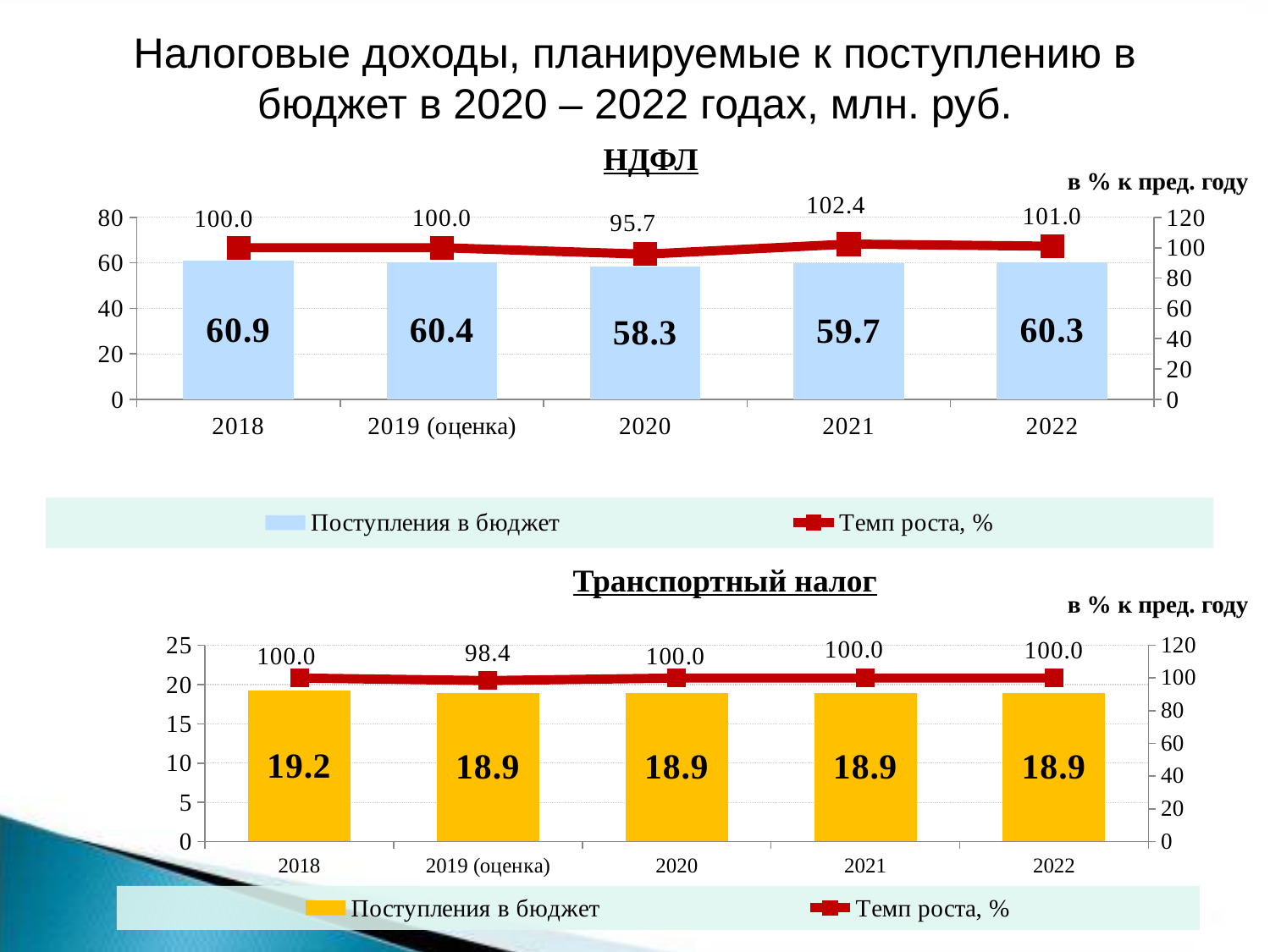
In the НДФЛ chart, which year has the lowest Поступления в бюджет value? 2020 How many years are shown on the x axis of the Транспортный налог chart? 5 In the НДФЛ chart, is the Поступления в бюджет value for 2021 larger or smaller than the value for 2022? smaller In the НДФЛ chart, what is the Темп роста, % value for 2021? 102.4 In the Транспортный налог chart, what is the Поступления в бюджет value for 2018? 19.2 In the НДФЛ chart, what is the difference between the Поступления в бюджет values for 2018 and 2020? 2.6 In the НДФЛ chart, which year has the highest Темп роста, % value? 2021 In the НДФЛ chart, what is the value of Поступления в бюджет for 2020? 58.3 In the Транспортный налог chart, which year has the lowest Темп роста, % value? 2019 (оценка) How many series does the legend of the НДФЛ chart list? 2 In the Транспортный налог chart, what is the Темп роста, % value for 2019 (оценка)? 98.4 What colour are the Поступления в бюджет bars in the Транспортный налог chart? Yellow